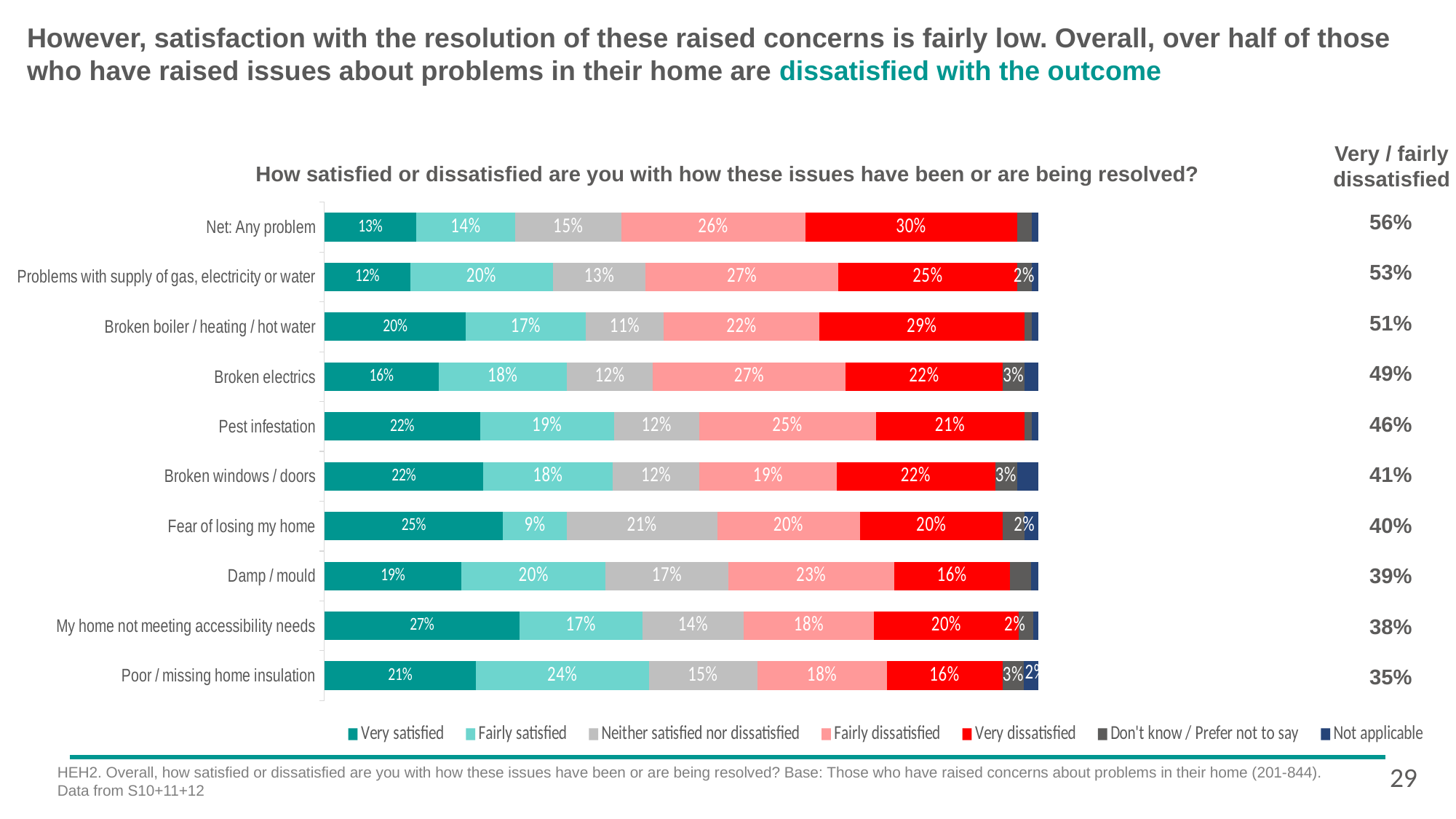
What percentage of respondents with a broken boiler / heating / hot water problem are very dissatisfied? 29% Which category has the highest 'Very satisfied' percentage? My home not meeting accessibility needs Which legend entry is shown in bright red? Very dissatisfied What is the difference between the 'Very dissatisfied' percentages for Net: Any problem and Damp / mould? 14% What is the 'Very / fairly dissatisfied' figure for Damp / mould? 39% Which is larger: the 'Fairly dissatisfied' value for Broken electrics or for Broken windows / doors? Broken electrics What percentage of respondents in the 'Fear of losing my home' category are fairly satisfied? 9% How many categories are shown on the chart? 10 Which category has the lowest 'Very / fairly dissatisfied' figure? Poor / missing home insulation How many series does the legend list? 7 What type of chart is shown on the slide? Stacked bar chart What is the combined 'Very satisfied' and 'Fairly satisfied' percentage for Pest infestation? 41%